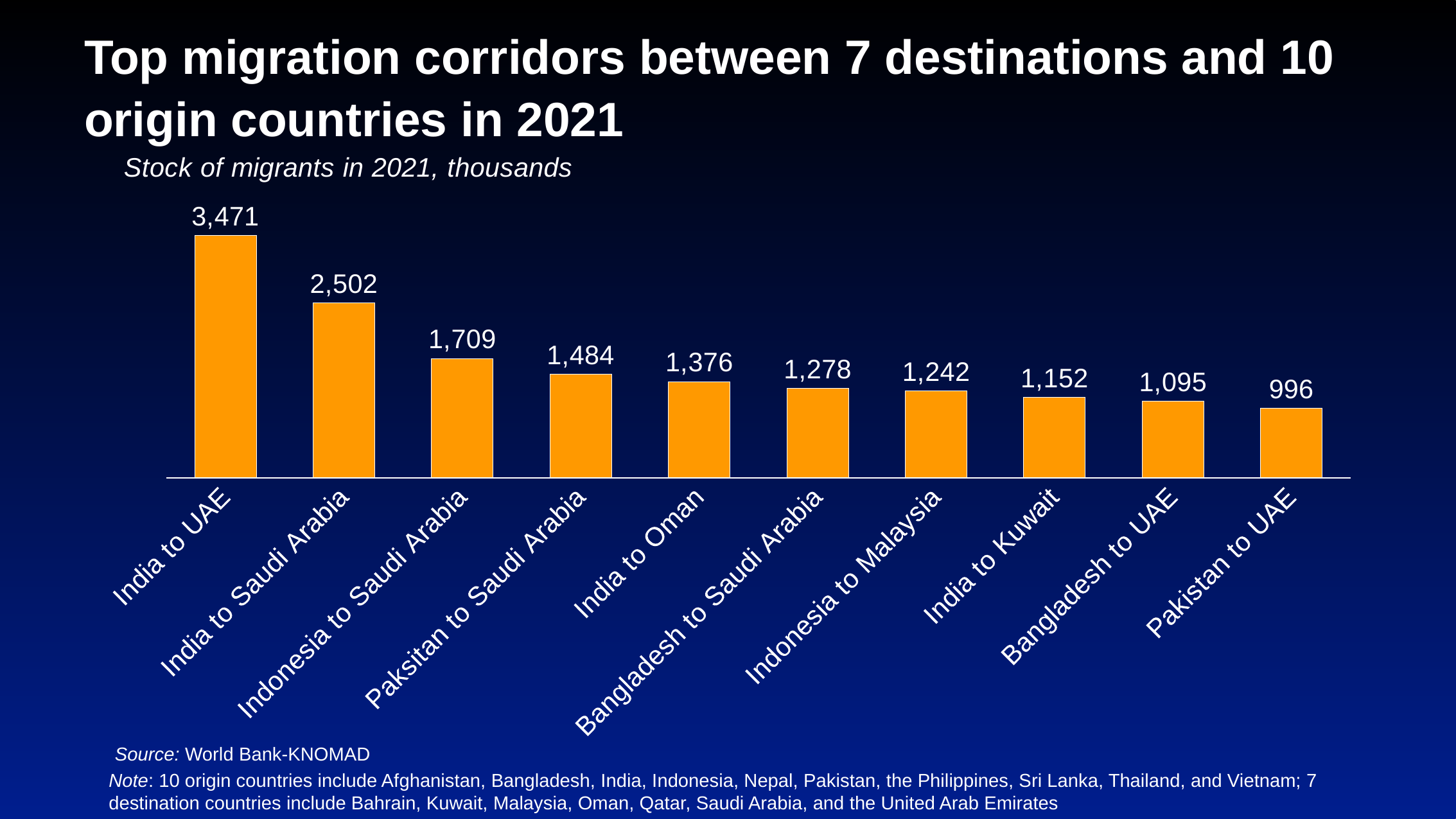
What is the value shown for Bangladesh to Saudi Arabia? 1,278 What is the difference between the India to UAE and India to Saudi Arabia values? 969 What is the value shown for Pakistan to UAE? 996 What is the source cited for the chart? World Bank-KNOMAD What kind of chart is shown on the slide? Bar chart Which migration corridor has the highest stock of migrants? India to UAE What is the stock of migrants for the India to UAE corridor? 3,471 How many migration corridors are shown in the chart? 10 Do the values rise or fall from left to right along the x axis? Fall What is the difference between the Indonesia to Saudi Arabia and Pakistan to Saudi Arabia values? 225 Which is larger, the value for India to Oman or the value for Indonesia to Malaysia? India to Oman Which migration corridor has the lowest stock of migrants? Pakistan to UAE